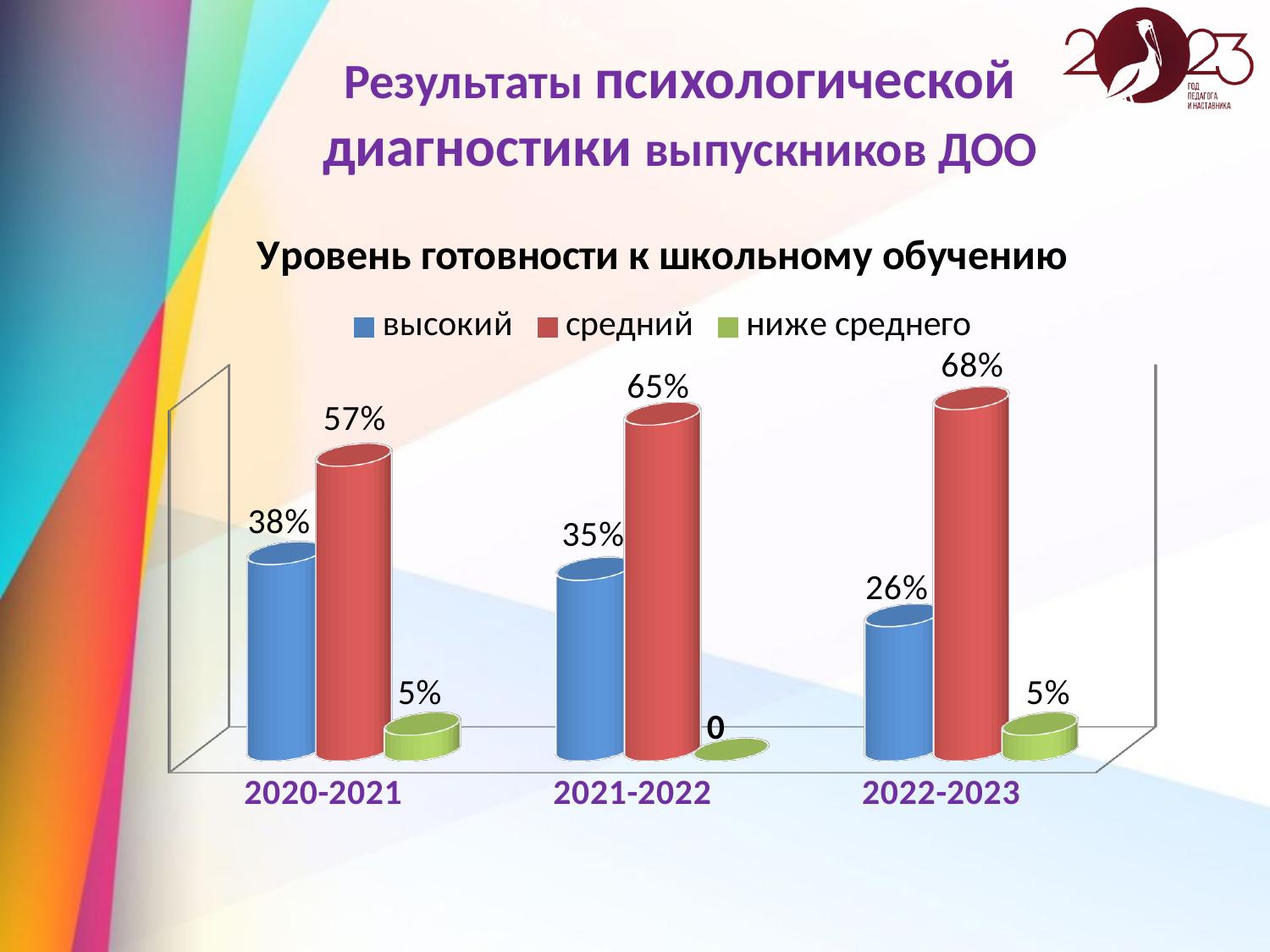
What is the value for "высокий" in 2020-2021? 38% Which is larger in 2021-2022: "высокий" or "средний"? средний Does the "высокий" value rise or fall from 2020-2021 to 2022-2023? fall What is the difference between the "средний" values for 2022-2023 and 2020-2021? 11% How many periods are shown on the x axis? 3 What is the value for "средний" in 2022-2023? 68% In which period is the "средний" value highest? 2022-2023 How many series does the legend list? 3 In which period is the "высокий" value lowest? 2022-2023 What is the value for "ниже среднего" in 2021-2022? 0 What kind of chart is shown on the slide? bar chart What is the title of the chart? Уровень готовности к школьному обучению